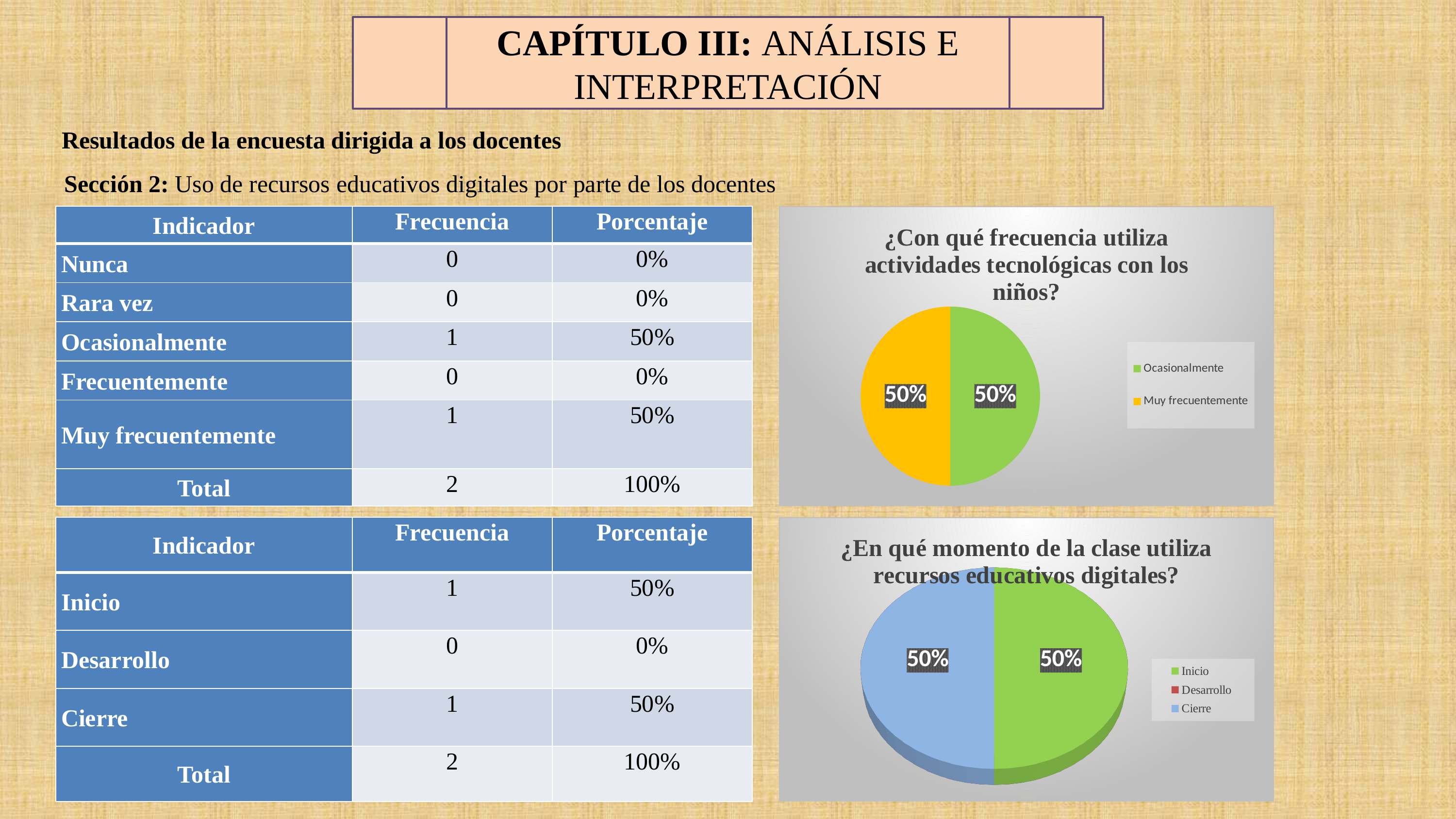
In the bottom-right pie chart, which colour represents Inicio? Green How many entries does the legend of the bottom-right pie chart list? 3 How many entries does the legend of the top-right pie chart list? 2 In the top-right pie chart, how many slices are drawn? 2 In the bottom-right pie chart, how many slices are visibly drawn? 2 In the top-right pie chart, what share is labelled for Ocasionalmente? 50% What kind of chart is the bottom-right chart titled "¿En qué momento de la clase utiliza recursos educativos digitales?"? Pie chart In the top-right pie chart, which colour represents Muy frecuentemente? Yellow In the bottom-right pie chart, what share is labelled for Cierre? 50% In the top-right pie chart, what share is labelled for Muy frecuentemente? 50% What kind of chart is the top-right chart titled "¿Con qué frecuencia utiliza actividades tecnológicas con los niños?"? Pie chart